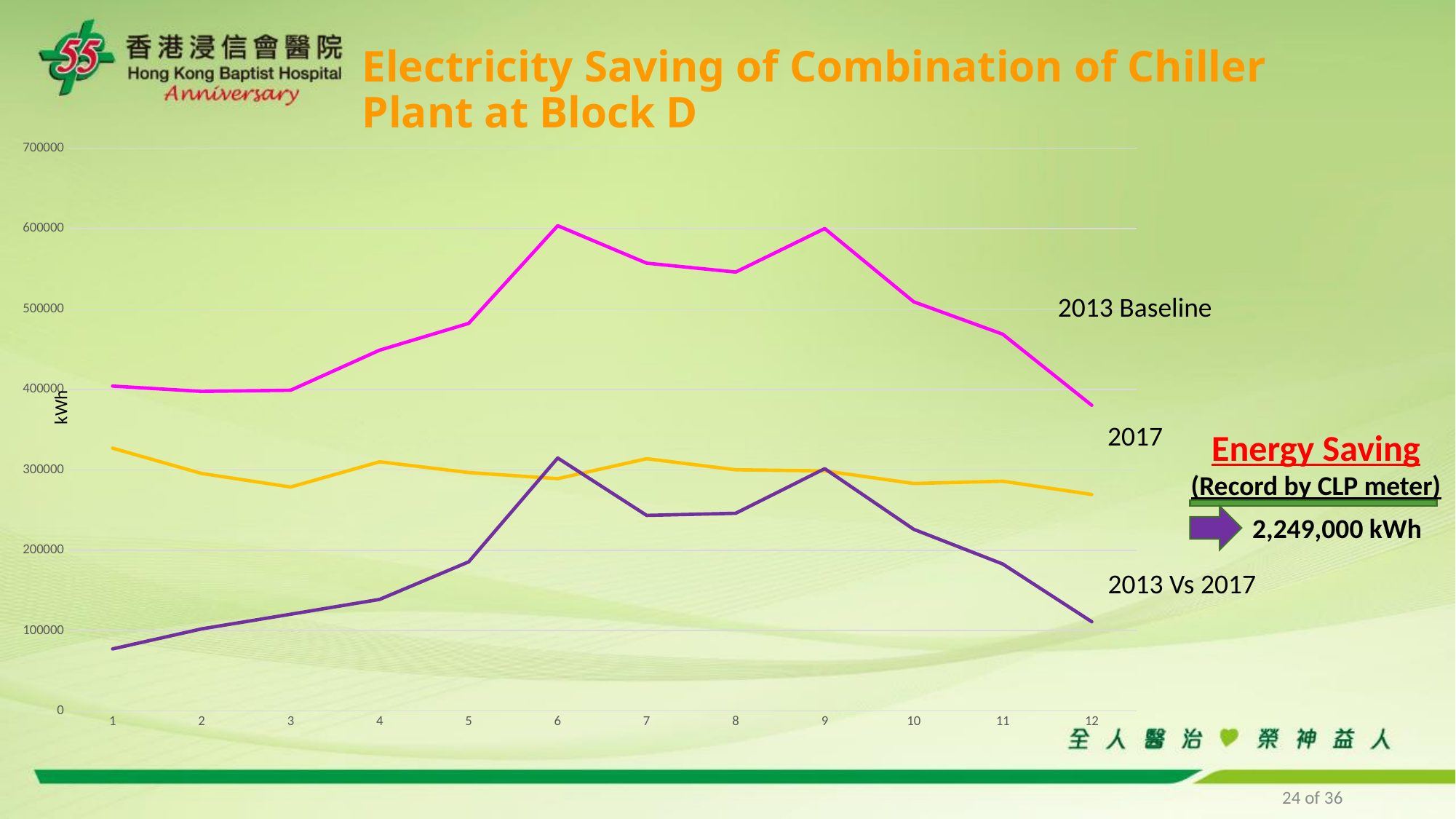
How many lines (series) are plotted on the chart? 3 Does the 2013 Baseline line rise or fall from point 9 to point 12? fall What kind of chart is shown on the slide? line chart Which series is plotted highest on the chart? 2013 Baseline At which x-axis point is the 2013 Vs 2017 line at its lowest? 1 What is the energy saving value stated on the slide (Record by CLP meter)? 2,249,000 kWh At point 6, which line is higher: 2013 Baseline or 2017? 2013 Baseline At which x-axis point is the 2013 Baseline line at its lowest? 12 Is the value of the 2013 Vs 2017 line at point 1 greater or less than 100000? less Is the value of the 2013 Baseline line at point 1 greater or less than 500000? less Is the value of the 2017 line at point 1 greater or less than 300000? greater How many points along the x axis does the chart have? 12